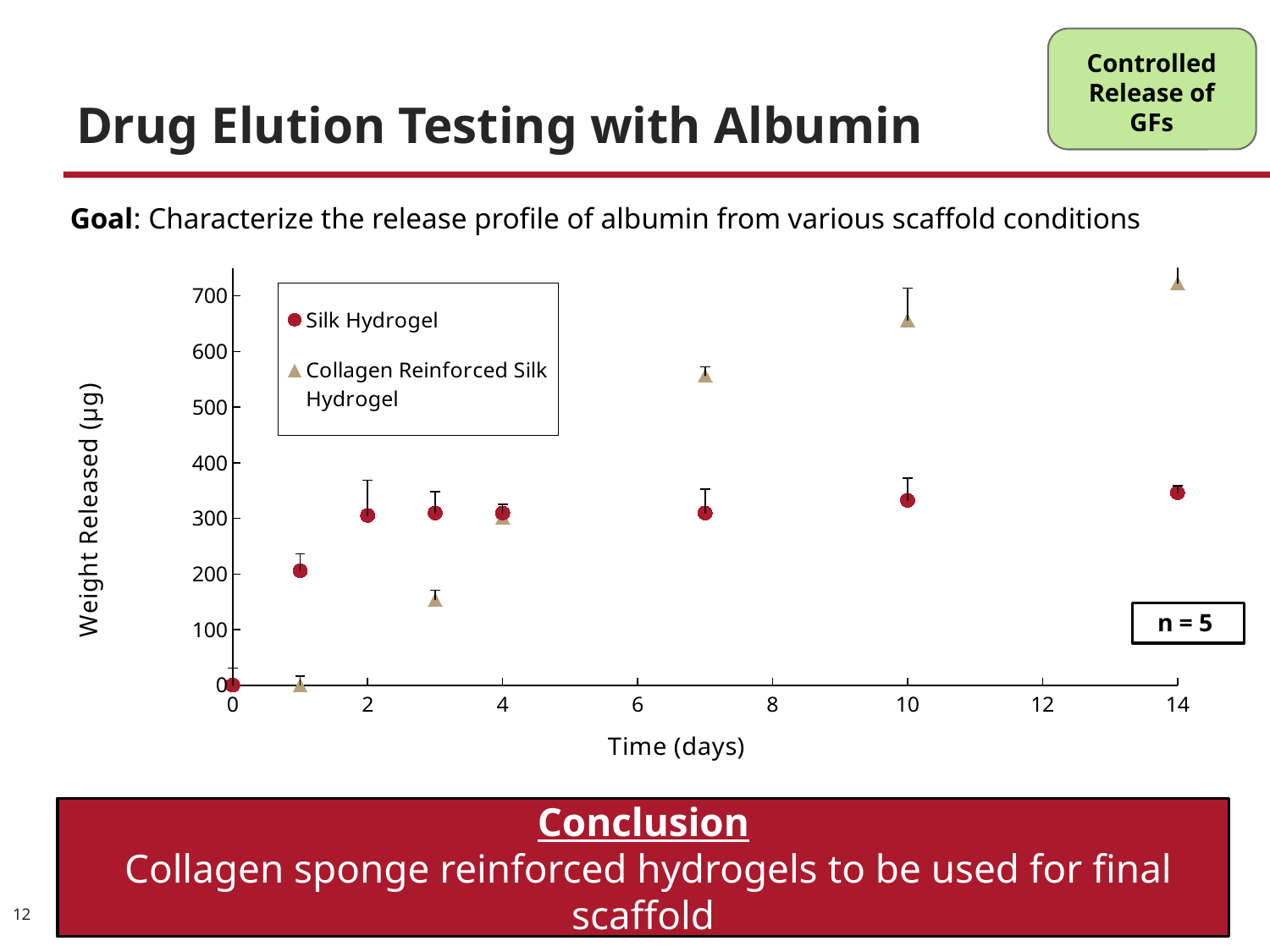
How many series does the chart legend list? 2 Is the value for Collagen Reinforced Silk Hydrogel at day 14 greater or less than 700? greater Is the value for Collagen Reinforced Silk Hydrogel at day 3 greater or less than 200? less What sample size is noted in the box on the chart? n = 5 Is the value for Silk Hydrogel at day 14 greater or less than 400? less What is the label of the y axis? Weight Released (µg) At day 14, which series has the higher weight released? Collagen Reinforced Silk Hydrogel At day 3, which series has the higher weight released? Silk Hydrogel What type of chart is shown on the slide? scatter chart Does the weight released for Collagen Reinforced Silk Hydrogel rise or fall from day 4 to day 14? rise